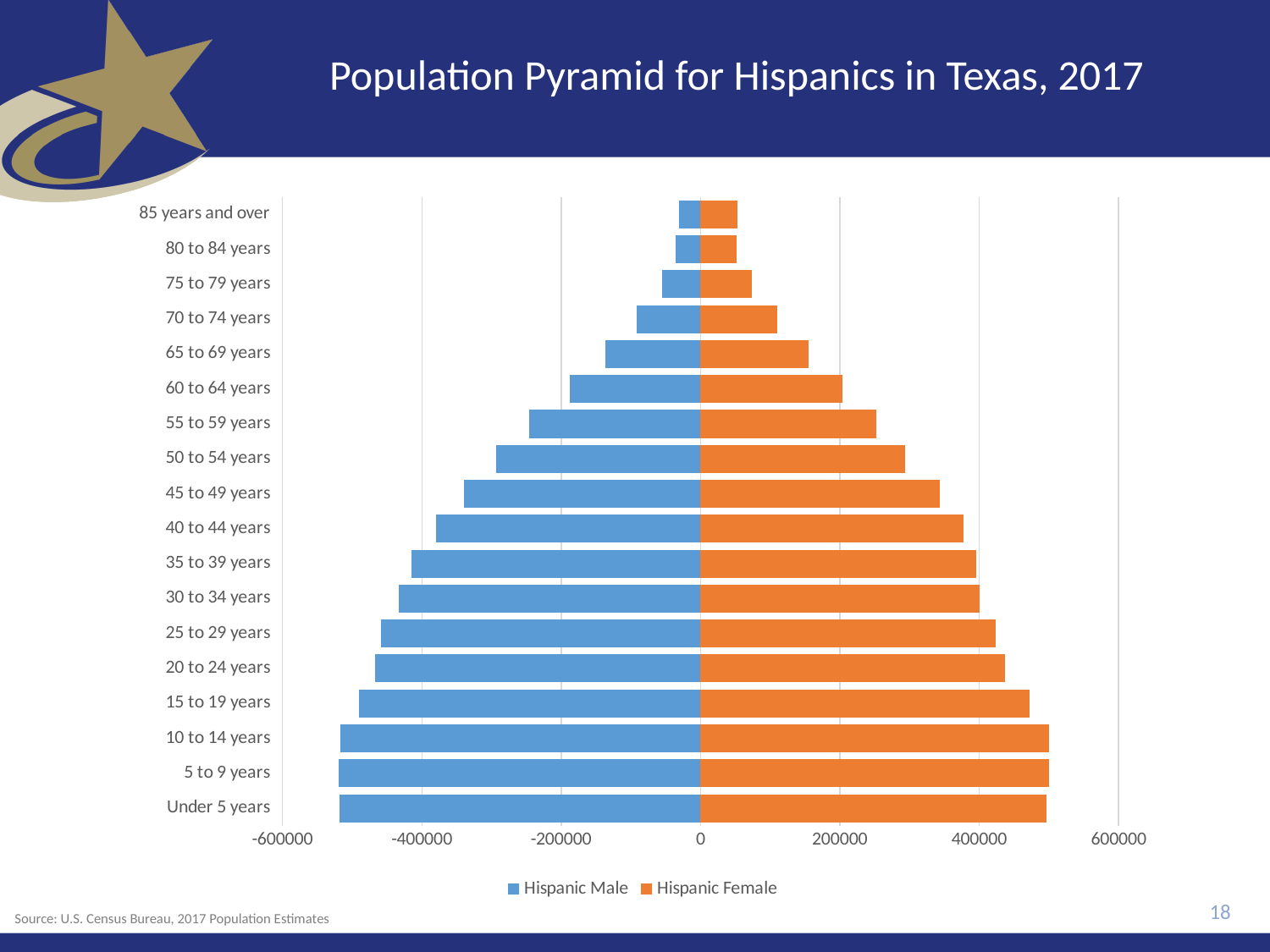
Which colour represents Hispanic Male in the chart? Blue How many age group categories are plotted on the chart? 18 Which is larger for Hispanic Female: the value for 70 to 74 years or the value for 75 to 79 years? 70 to 74 years Which is larger for Hispanic Female: the value for 40 to 44 years or the value for 60 to 64 years? 40 to 44 years Is the Hispanic Female value for 85 years and over greater or less than 200000? less Is the Hispanic Male value for 5 to 9 years greater or less than -400000? less Do the Hispanic Female bars generally get longer or shorter as the age groups get older? shorter What kind of chart is shown on the slide? Bar chart Is the Hispanic Female value for 10 to 14 years greater or less than 400000? greater How many series does the legend list? 2 What is the title of the chart? Population Pyramid for Hispanics in Texas, 2017